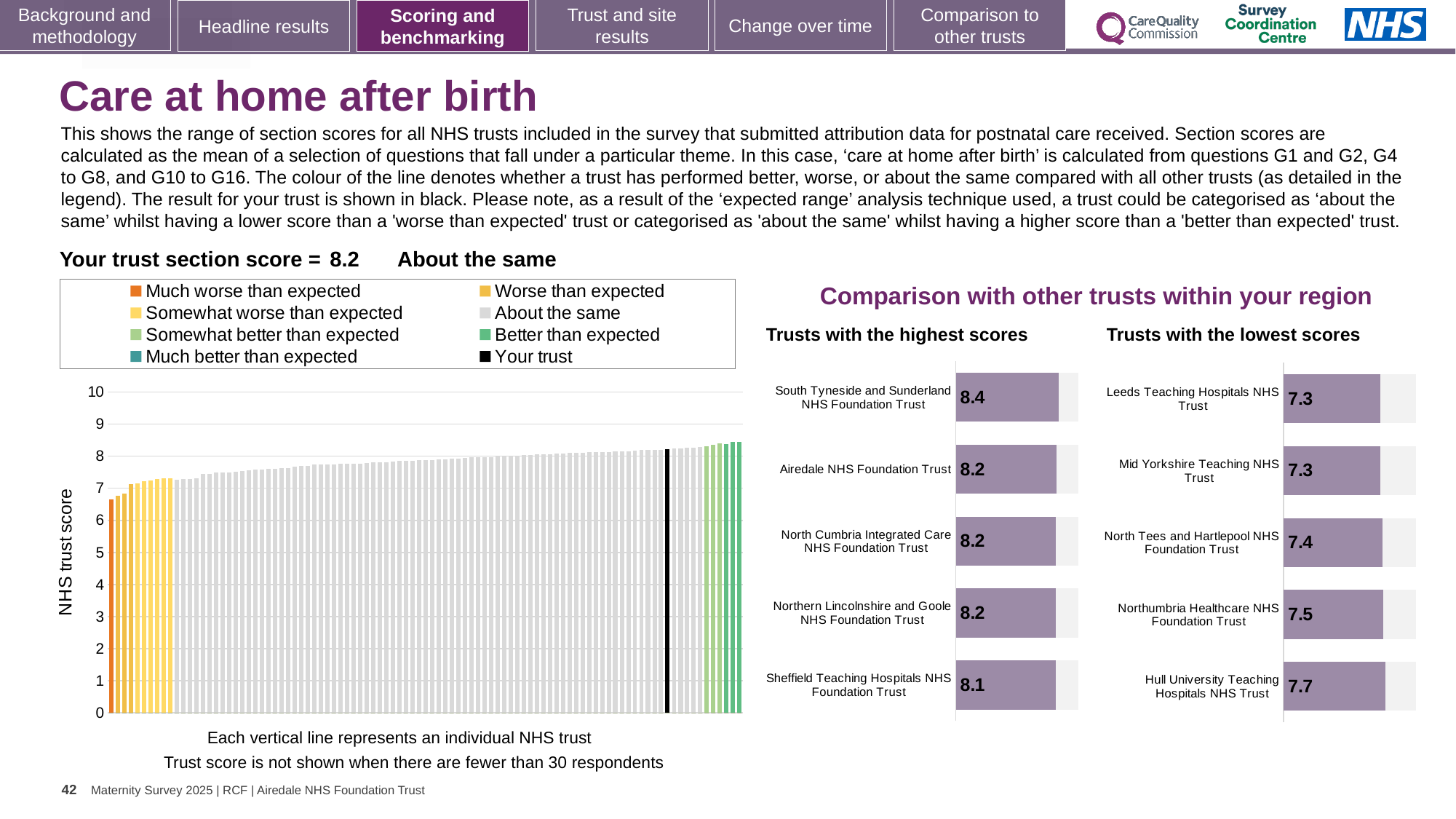
In the 'Trusts with the lowest scores' chart, which trust has the highest score? Hull University Teaching Hospitals NHS Trust How many entries does the legend of the 'NHS trust score' chart list? 8 In the 'NHS trust score' chart, what is the section score for your trust (the black bar)? 8.2 In the 'Trusts with the lowest scores' chart, which has the larger score: North Tees and Hartlepool NHS Foundation Trust or Northumbria Healthcare NHS Foundation Trust? Northumbria Healthcare NHS Foundation Trust In the 'Trusts with the highest scores' chart, what is the score for South Tyneside and Sunderland NHS Foundation Trust? 8.4 How many trusts are shown in the 'Trusts with the highest scores' chart? 5 In the 'Trusts with the lowest scores' chart, what is the score for Hull University Teaching Hospitals NHS Trust? 7.7 In the 'NHS trust score' chart, do the values rise or fall from left to right? Rise In the 'Trusts with the highest scores' chart, which trust has the highest score? South Tyneside and Sunderland NHS Foundation Trust In the 'Trusts with the lowest scores' chart, what is the difference between the scores of Hull University Teaching Hospitals NHS Trust and Leeds Teaching Hospitals NHS Trust? 0.4 What kind of chart is the 'NHS trust score' chart on the left? Bar chart In the 'Trusts with the highest scores' chart, what is the difference between the scores of South Tyneside and Sunderland NHS Foundation Trust and Sheffield Teaching Hospitals NHS Foundation Trust? 0.3